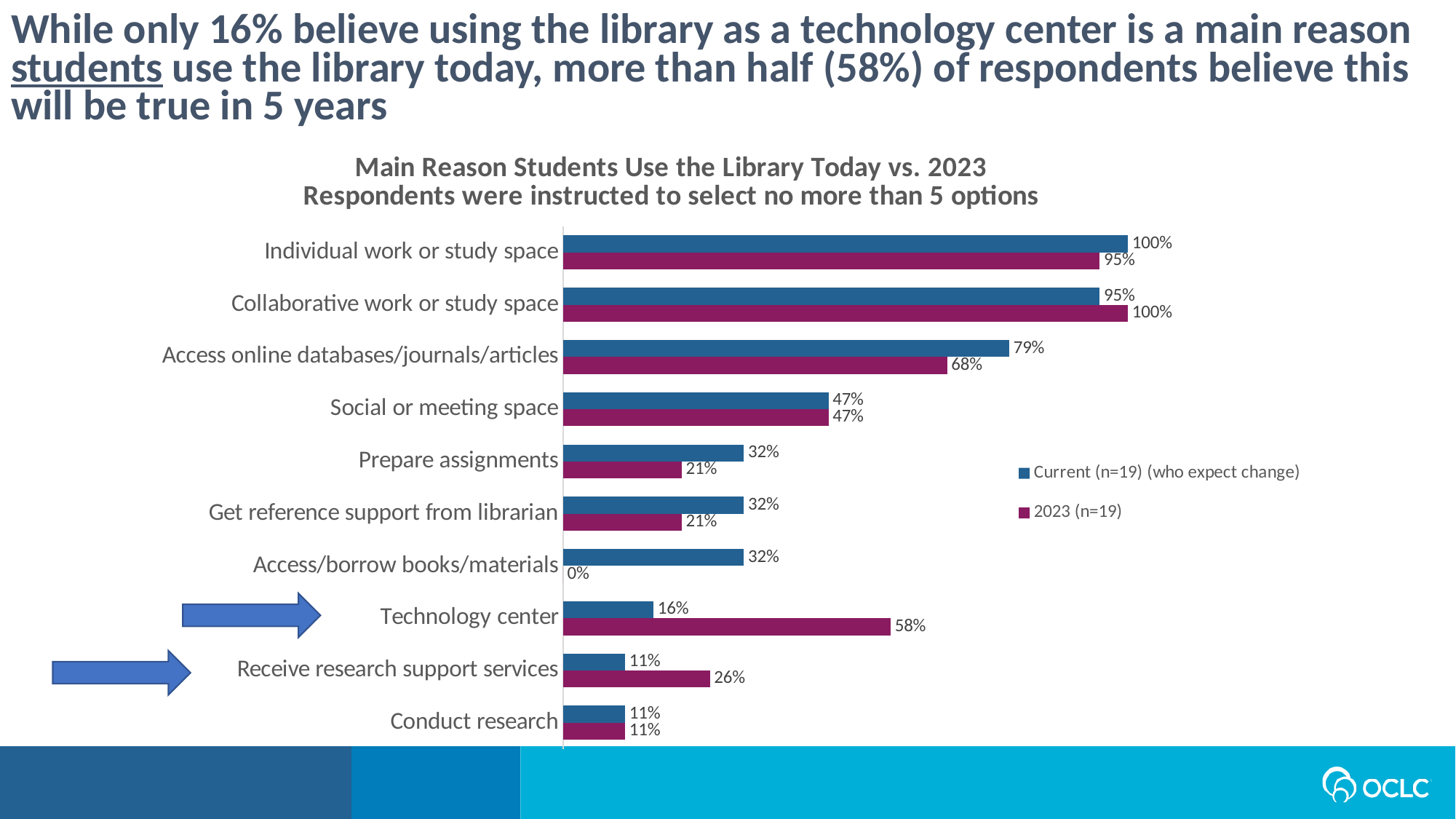
Which category has the highest Current value? Individual work or study space What is the title of the chart? Main Reason Students Use the Library Today vs. 2023 How many series does the legend list? 2 How many categories are shown in the chart? 10 What is the Current value for Technology center? 16% What is the 2023 value for Technology center? 58% What is the 2023 value for Access/borrow books/materials? 0% What is the difference between the 2023 and Current values for Technology center? 42% Which is larger for Receive research support services, the Current value or the 2023 value? 2023 What kind of chart is shown on the slide? Bar chart What is the Current value for Access online databases/journals/articles? 79% Which category has the lowest 2023 value? Access/borrow books/materials